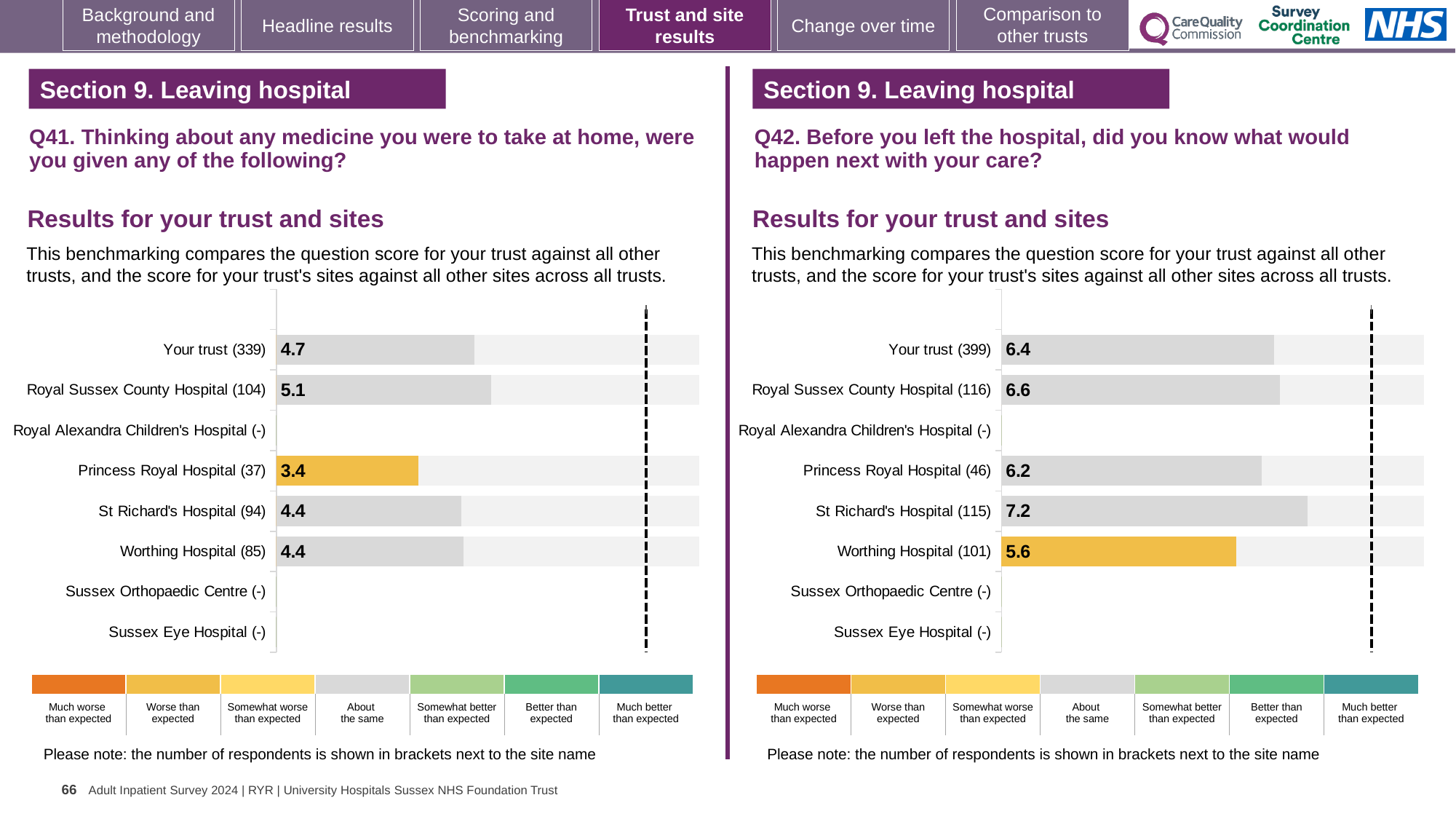
In the Q42 chart on the right, which site has the lowest score? Worthing Hospital In the Q41 chart on the left, how many respondents are shown for Your trust? 339 In the Q41 chart on the left, what is the difference between the scores for Royal Sussex County Hospital and Princess Royal Hospital? 1.7 In the Q41 chart on the left, what type of chart is used? Bar chart In the Q42 chart on the right, what is the score for St Richard's Hospital? 7.2 In the Q41 chart on the left, which site has the lowest score? Princess Royal Hospital In the Q41 chart on the left, what is the score for Royal Sussex County Hospital? 5.1 In the Q41 chart on the left, which site's bar is coloured orange-yellow rather than grey? Princess Royal Hospital In the Q42 chart on the right, is the score for Your trust or Royal Sussex County Hospital larger? Royal Sussex County Hospital In the Q42 chart on the right, what is the difference between the scores for St Richard's Hospital and Worthing Hospital? 1.6 In the Q42 chart on the right, how many sites have a score shown as a bar? 4 In the Q42 chart on the right, which site has the highest score? St Richard's Hospital